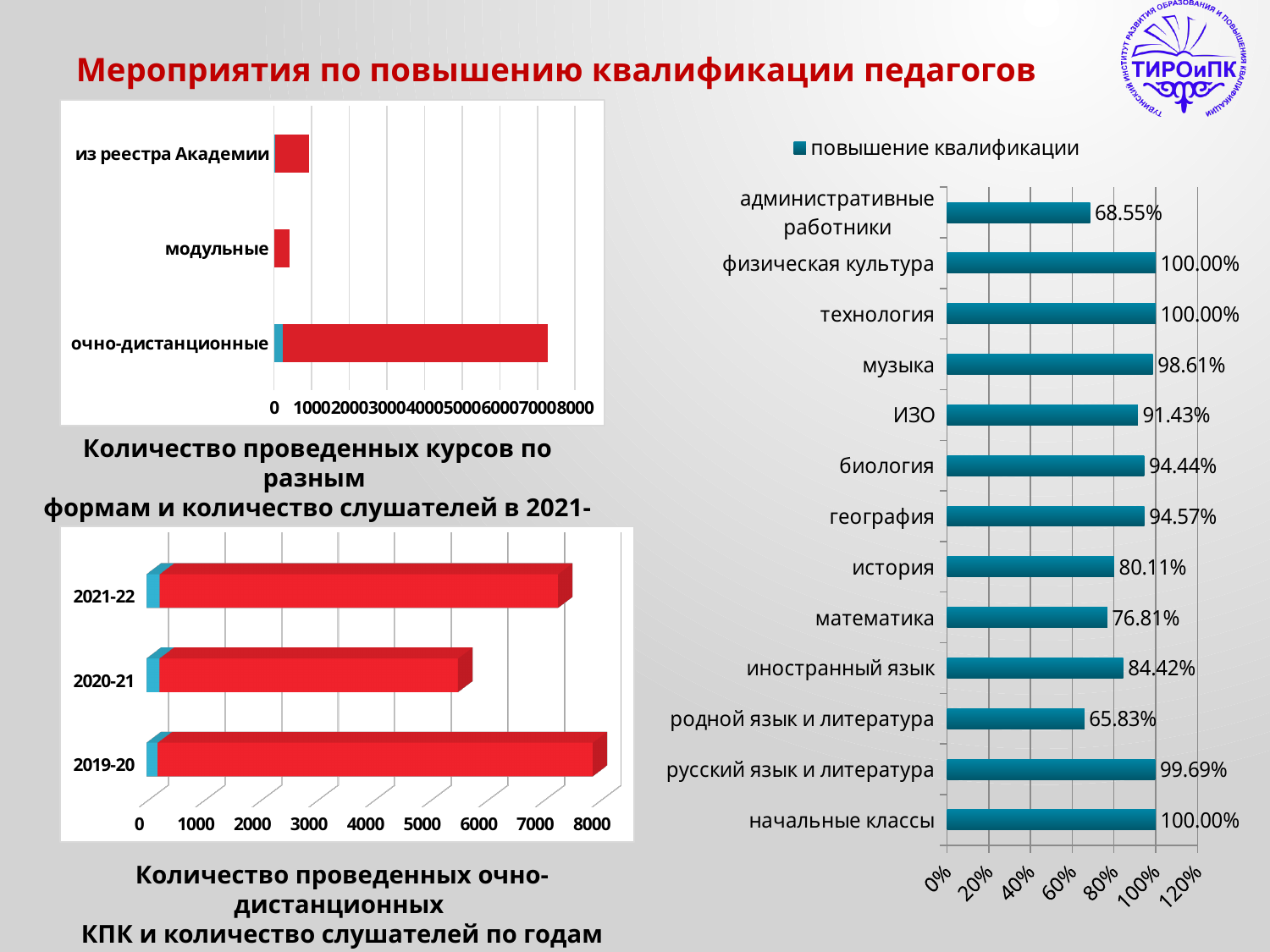
What kind of chart is the right chart? bar chart In the bottom-left chart, which red bar is longer: 2019-20 or 2020-21? 2019-20 In the right chart, what is the difference between the values for география and биология? 0.13% What is the legend entry of the right chart? повышение квалификации In the right chart, what is the value for история? 80.11% In the bottom-left chart, is the red bar for 2020-21 greater or less than 4000? greater How many categories are shown in the right chart? 13 In the right chart, which is larger: the value for ИЗО or for иностранный язык? ИЗО In the right chart, what is the difference between the values for административные работники and родной язык и литература? 2.72% How many series does the legend of the right chart list? 1 In the right chart, which category has the lowest value? родной язык и литература In the right chart, what is the value for математика? 76.81%